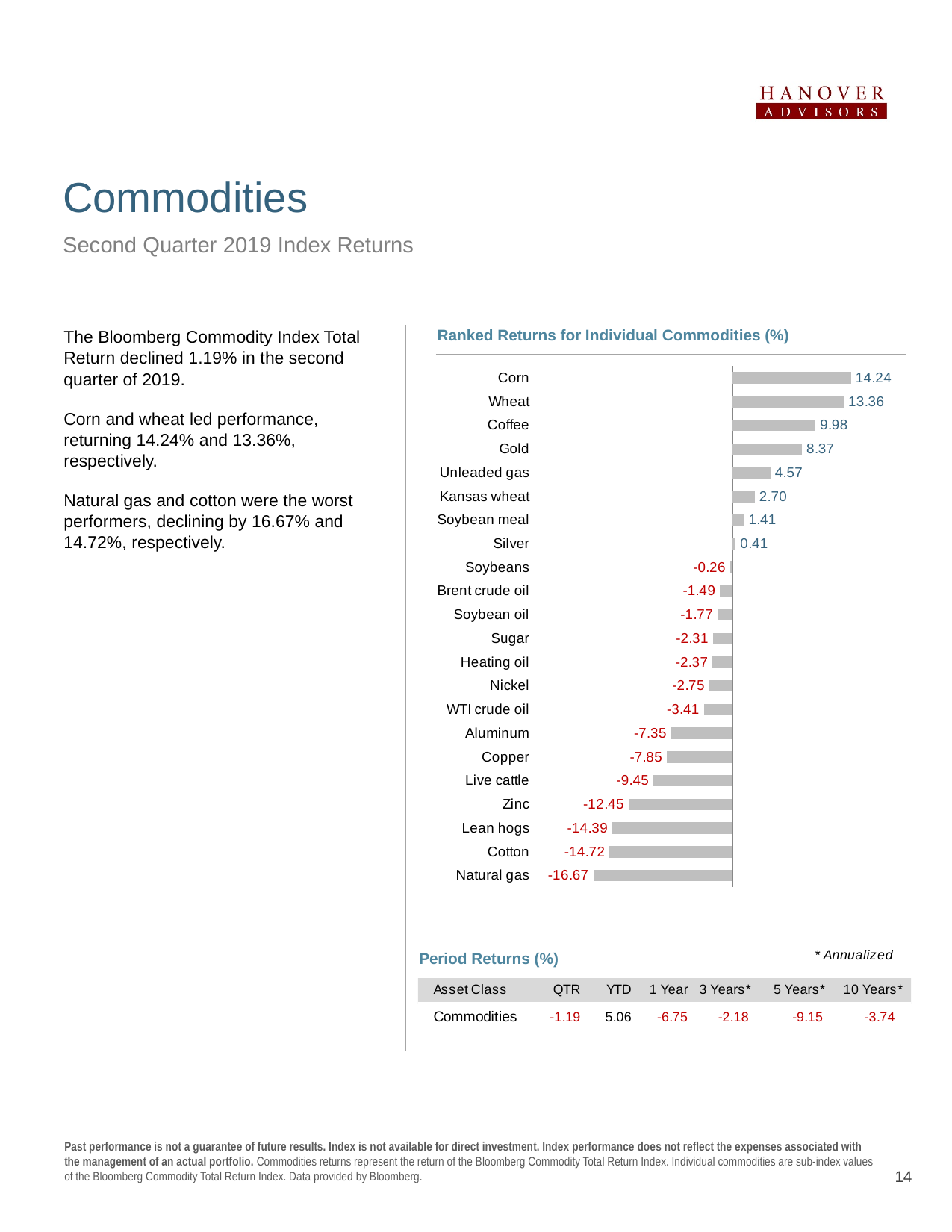
What is the value for Gold in the Ranked Returns for Individual Commodities chart? 8.37 What is the title of the bar chart on the slide? Ranked Returns for Individual Commodities (%) Which commodity has the lowest return in the Ranked Returns for Individual Commodities chart? Natural gas What is the difference between the values for Cotton and Lean hogs in the Ranked Returns for Individual Commodities chart? 0.33 What is the value for Natural gas in the Ranked Returns for Individual Commodities chart? -16.67 What kind of chart is the Ranked Returns for Individual Commodities chart? Bar chart Which commodity has the highest return in the Ranked Returns for Individual Commodities chart? Corn What is the value for Silver in the Ranked Returns for Individual Commodities chart? 0.41 How many commodities are shown in the Ranked Returns for Individual Commodities chart? 22 Which has a higher value in the Ranked Returns for Individual Commodities chart, Coffee or Unleaded gas? Coffee What is the value for Corn in the Ranked Returns for Individual Commodities chart? 14.24 What is the difference between the values for Corn and Wheat in the Ranked Returns for Individual Commodities chart? 0.88